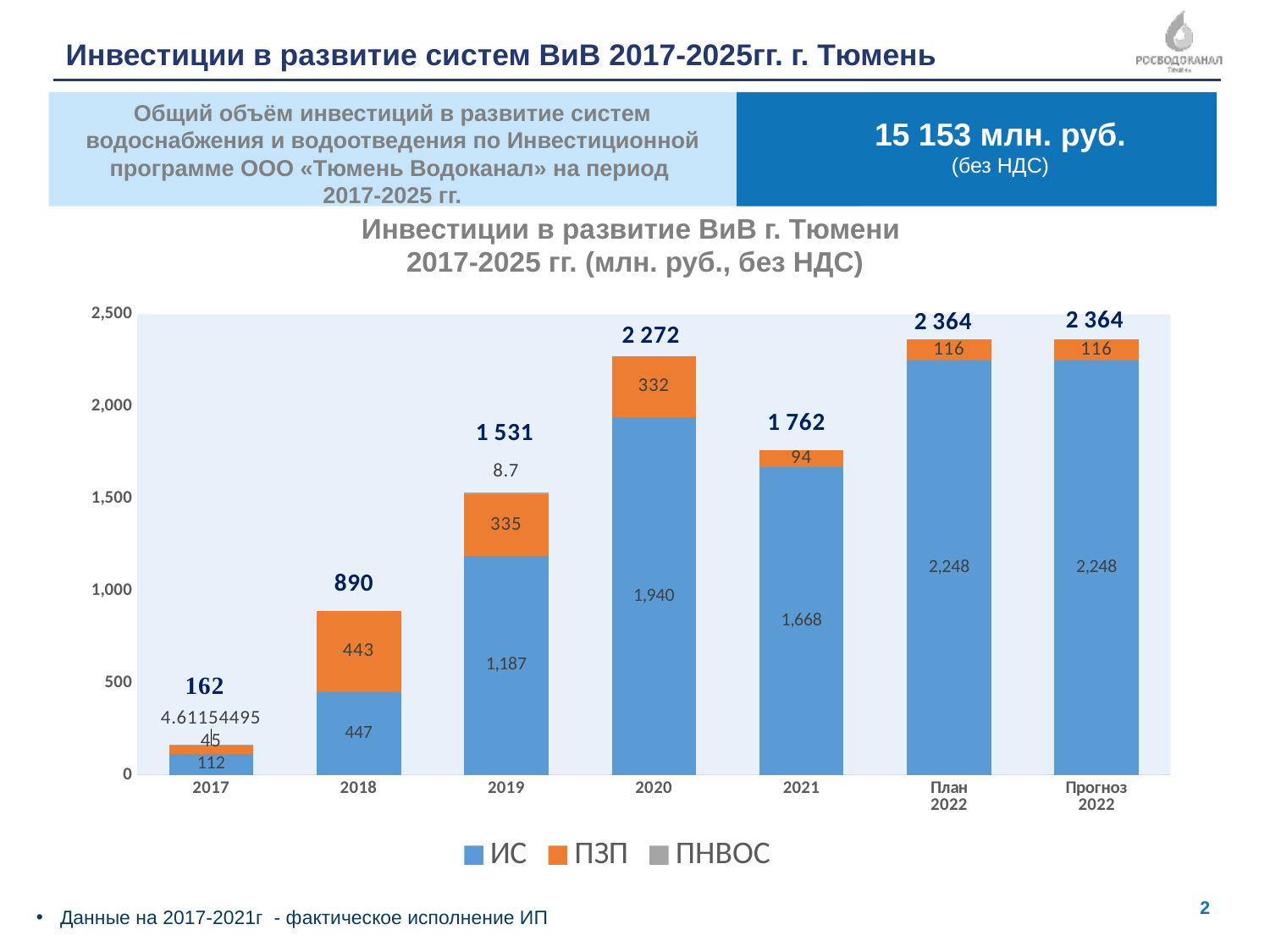
Which is larger, the ПЗП value for 2019 or the ПЗП value for 2020? 2019 What is the ПНВОС value for 2019? 8.7 Is the total for 2018 greater or less than 1,000? less What is the difference between the total for 2020 and the total for 2021? 510 How many categories are shown on the x axis? 7 What kind of chart is shown on the slide? stacked bar chart How many series does the legend list? 3 What is the total value of the bar for 2020? 2 272 What is the ПЗП value for 2018? 443 What is the ИС value for 2021? 1,668 What is the ИС value for План 2022? 2,248 Which year has the lowest total investment? 2017